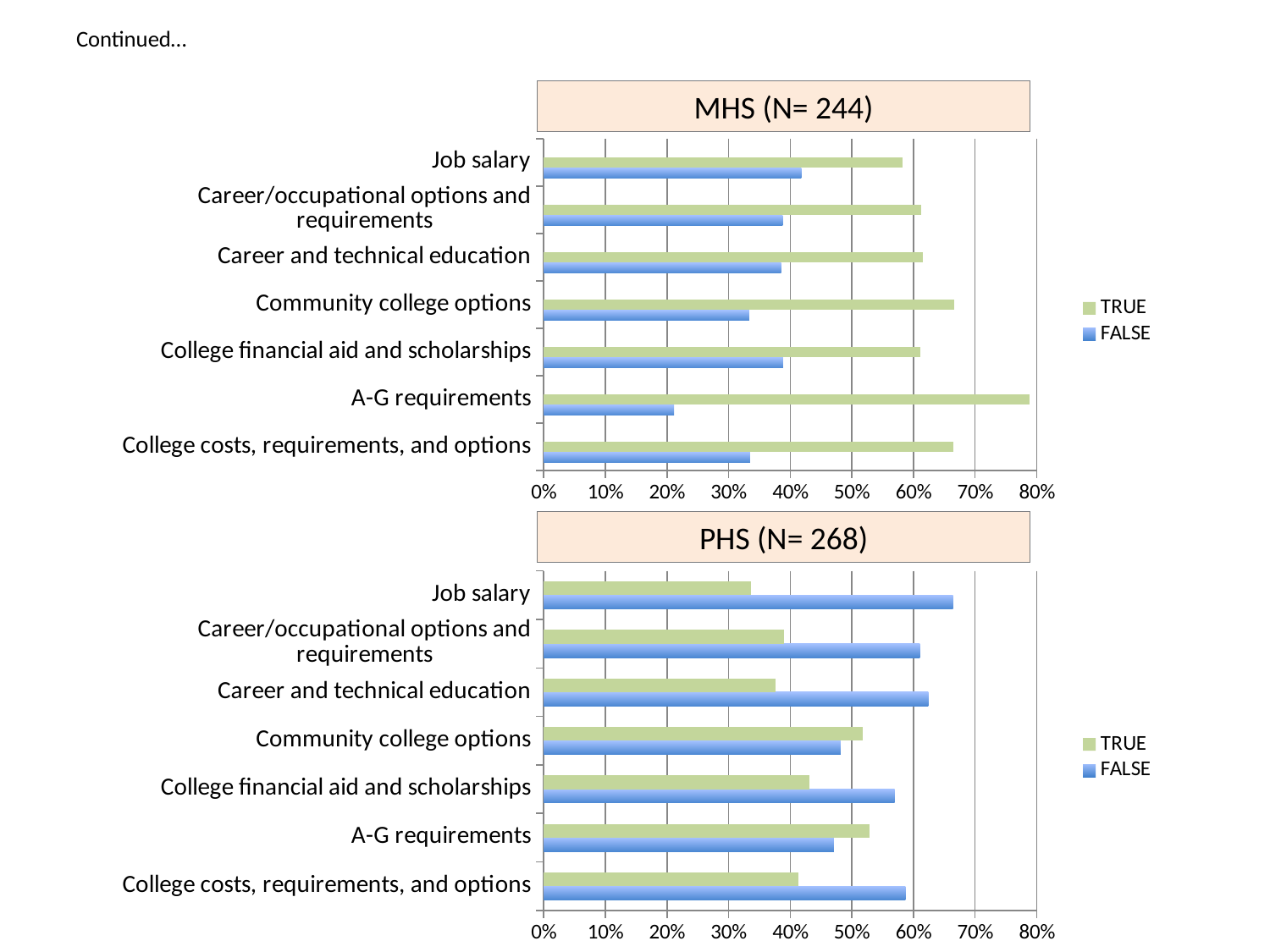
In the MHS (N= 244) chart, is the FALSE value for Job salary greater or less than 50%? less In the PHS (N= 268) chart, is the FALSE value for Job salary greater or less than 60%? greater In the MHS (N= 244) chart, which is larger for Community college options, the TRUE value or the FALSE value? TRUE How many categories are shown in the PHS (N= 268) chart? 7 In the PHS (N= 268) chart, which category has the highest FALSE value? Job salary In the MHS (N= 244) chart, which category has the lowest FALSE value? A-G requirements In the MHS (N= 244) chart, which category has the highest TRUE value? A-G requirements What kind of chart is the MHS (N= 244) chart? Bar chart In the PHS (N= 268) chart, which is larger for College financial aid and scholarships, the TRUE value or the FALSE value? FALSE In the PHS (N= 268) chart, which category has the lowest TRUE value? Job salary In the MHS (N= 244) chart, is the TRUE value for A-G requirements greater or less than 70%? greater How many series does the legend of the MHS (N= 244) chart list? 2